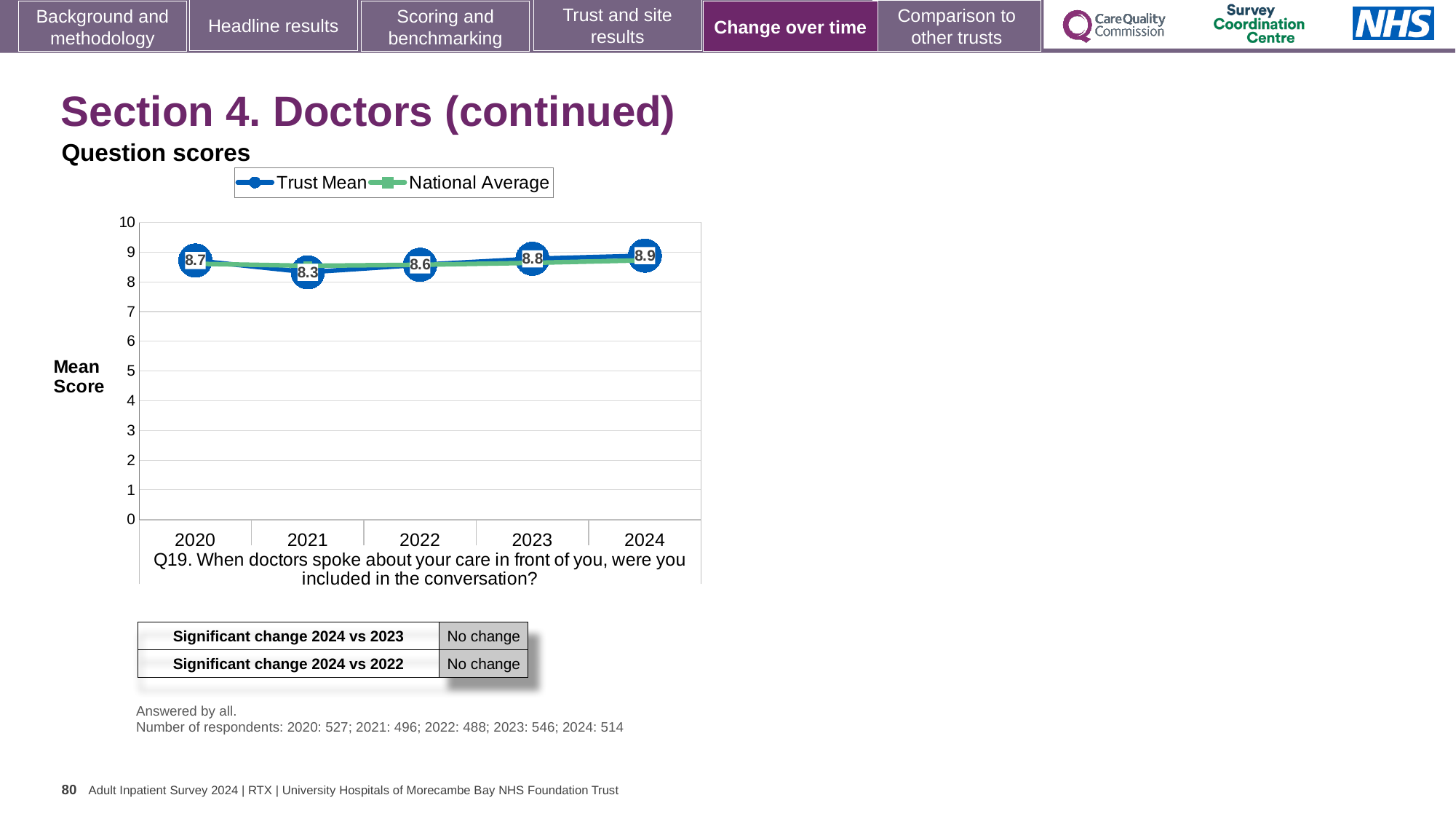
What is the Trust Mean score for 2024? 8.9 What kind of chart is shown on the slide? line chart What is the difference between the Trust Mean scores for 2024 and 2021? 0.6 Does the Trust Mean rise or fall from 2021 to 2024? rise What is the Trust Mean score for 2020? 8.7 In which year is the Trust Mean score lowest? 2021 What is the Trust Mean score for 2021? 8.3 In which year is the Trust Mean score highest? 2024 Is the Trust Mean value for 2021 greater or less than 9? less How many series does the legend list? 2 How many years are plotted on the x axis? 5 Which is larger, the Trust Mean score for 2022 or for 2023? 2023